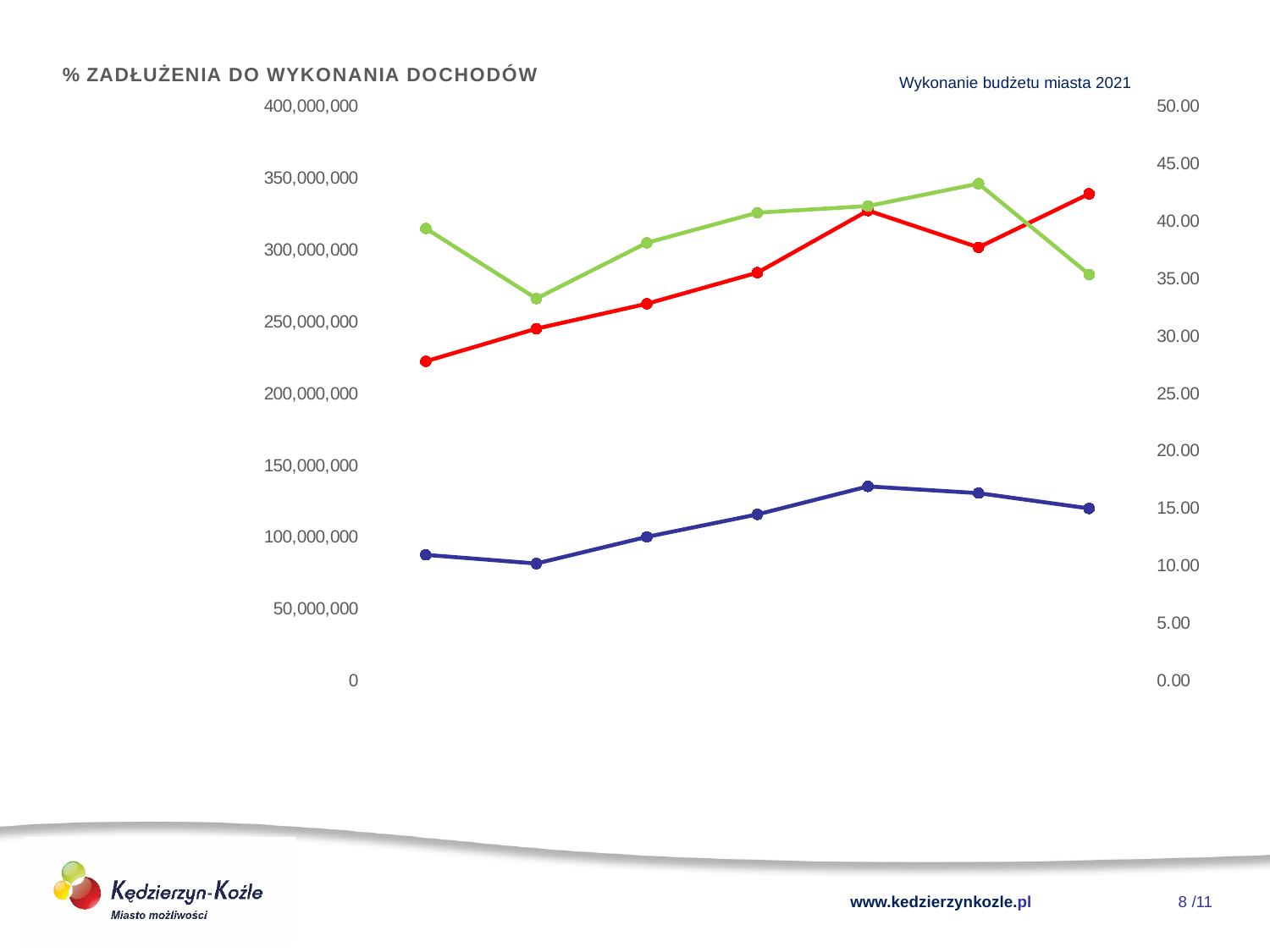
Which line lies lowest on the chart across all points: the red, green or blue one? blue What kind of chart is shown on the slide? line chart How many lines are plotted on the chart? 3 Does the blue line rise or fall between its fifth and seventh points? fall What is the highest value shown on the left vertical axis? 400,000,000 Does the red line generally rise or fall from left to right? rise How many data points does the red line have? 7 What is the title of the chart? % ZADŁUŻENIA DO WYKONANIA DOCHODÓW